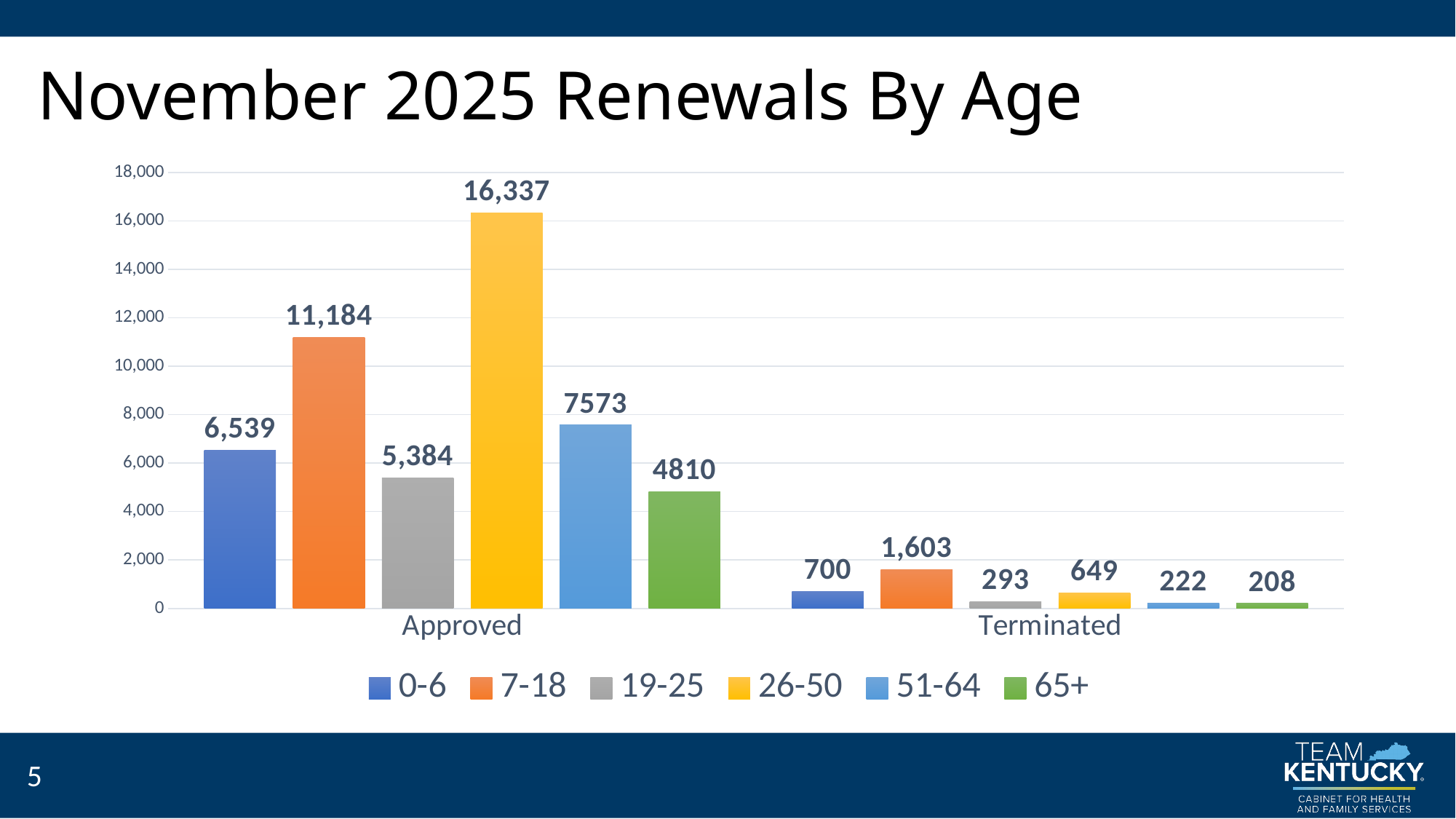
What is the Terminated value for the 7-18 age group? 1,603 How many categories are shown on the x axis? 2 What is the Approved value for the 65+ age group? 4810 Which is larger, the Approved value for 51-64 or for 19-25? 51-64 What is the difference between the Approved values for 7-18 and 0-6? 4,645 Which age group has the highest Approved value? 26-50 How many series does the legend list? 6 What is the Approved value for the 26-50 age group? 16,337 Is the Approved value for 0-6 greater or less than 8,000? less Which age group has the lowest Terminated value? 65+ What is the title of the slide? November 2025 Renewals By Age What kind of chart is shown on the slide? bar chart